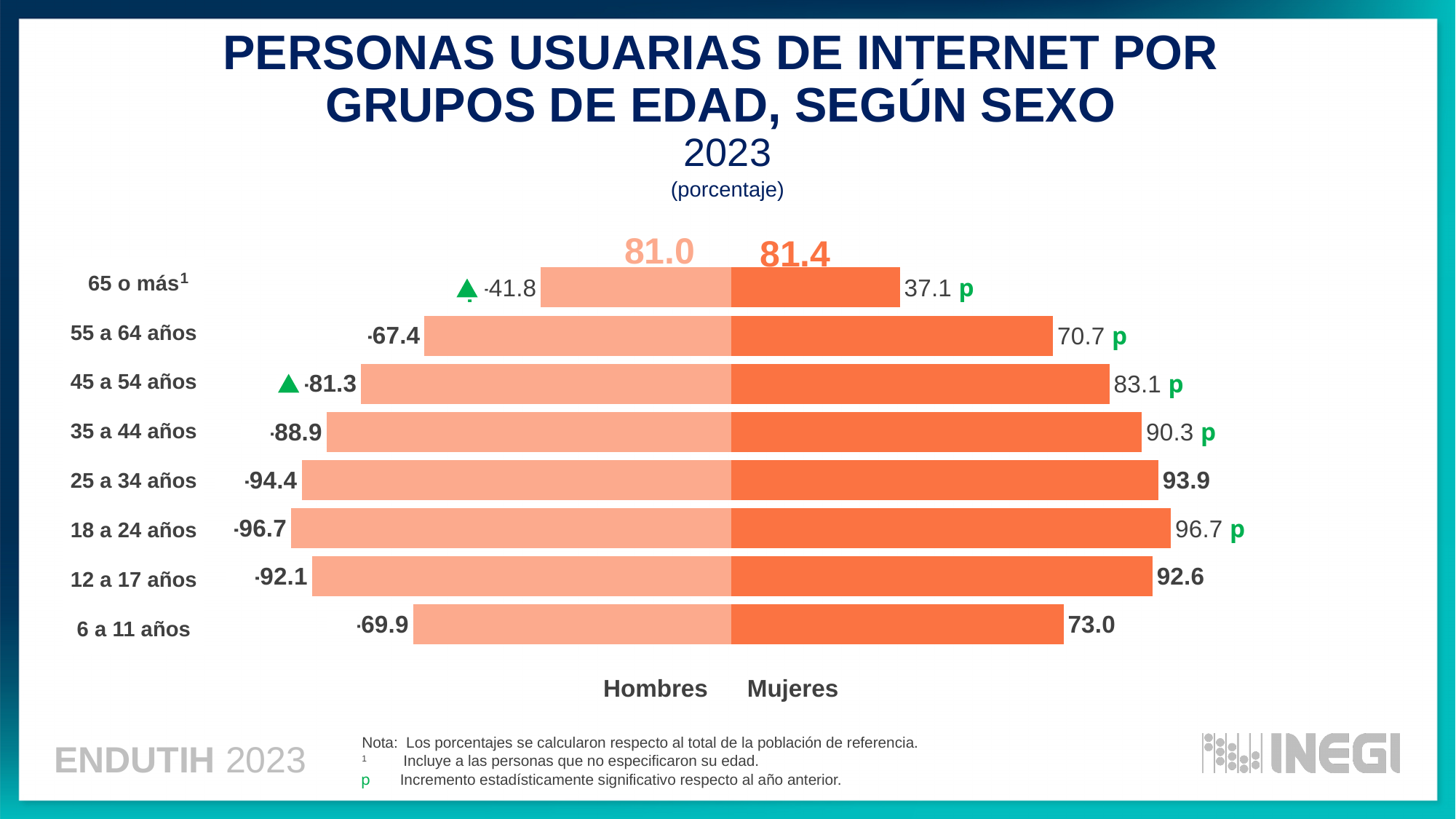
What is the difference between the Mujeres and Hombres values in the 45 a 54 años age group? 1.8 What is the value for Mujeres in the 55 a 64 años age group? 70.7 In the 25 a 34 años age group, which is larger, the value for Hombres or for Mujeres? Hombres What kind of chart is shown on the slide? Bar chart How many series does the chart show? 2 What are the two series named in the legend? Hombres and Mujeres How many age groups are shown in the chart? 8 What is the overall value shown for Mujeres at the top of the chart? 81.4 Which age group has the lowest value for Mujeres? 65 o más What is the value for Mujeres in the 6 a 11 años age group? 73.0 Which age group has the highest value for Hombres? 18 a 24 años What is the value for Hombres in the 65 o más age group? 41.8